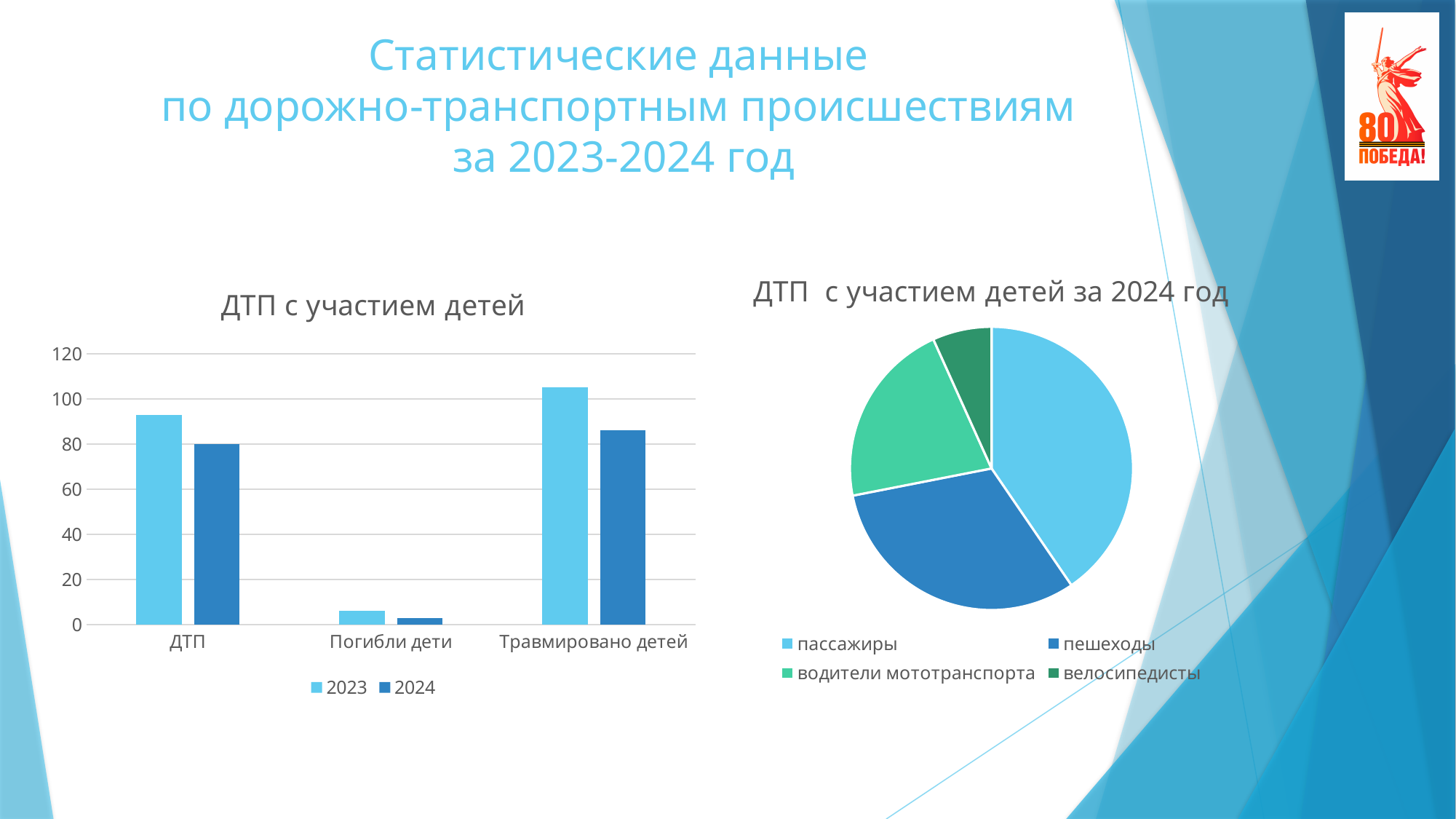
In the pie chart "ДТП с участием детей за 2024 год", how many slices does the legend list? 4 In the chart "ДТП с участием детей", which category has the highest 2023 value? Травмировано детей What kind of chart is the chart titled "ДТП с участием детей"? bar chart In the chart "ДТП с участием детей", is the 2024 value for Травмировано детей greater or less than 100? less In the pie chart "ДТП с участием детей за 2024 год", which slice is the largest? пассажиры What kind of chart is the chart titled "ДТП с участием детей за 2024 год"? pie chart In the chart "ДТП с участием детей", which category has the lowest values? Погибли дети In the chart "ДТП с участием детей", which is larger for ДТП: the 2023 value or the 2024 value? 2023 In the chart "ДТП с участием детей", is the 2023 value for Травмировано детей greater or less than 100? greater In the chart "ДТП с участием детей", is the 2023 value for Погибли дети greater or less than 20? less In the chart "ДТП с участием детей", how many series does the legend list? 2 In the chart "ДТП с участием детей", how many categories are shown on the x axis? 3